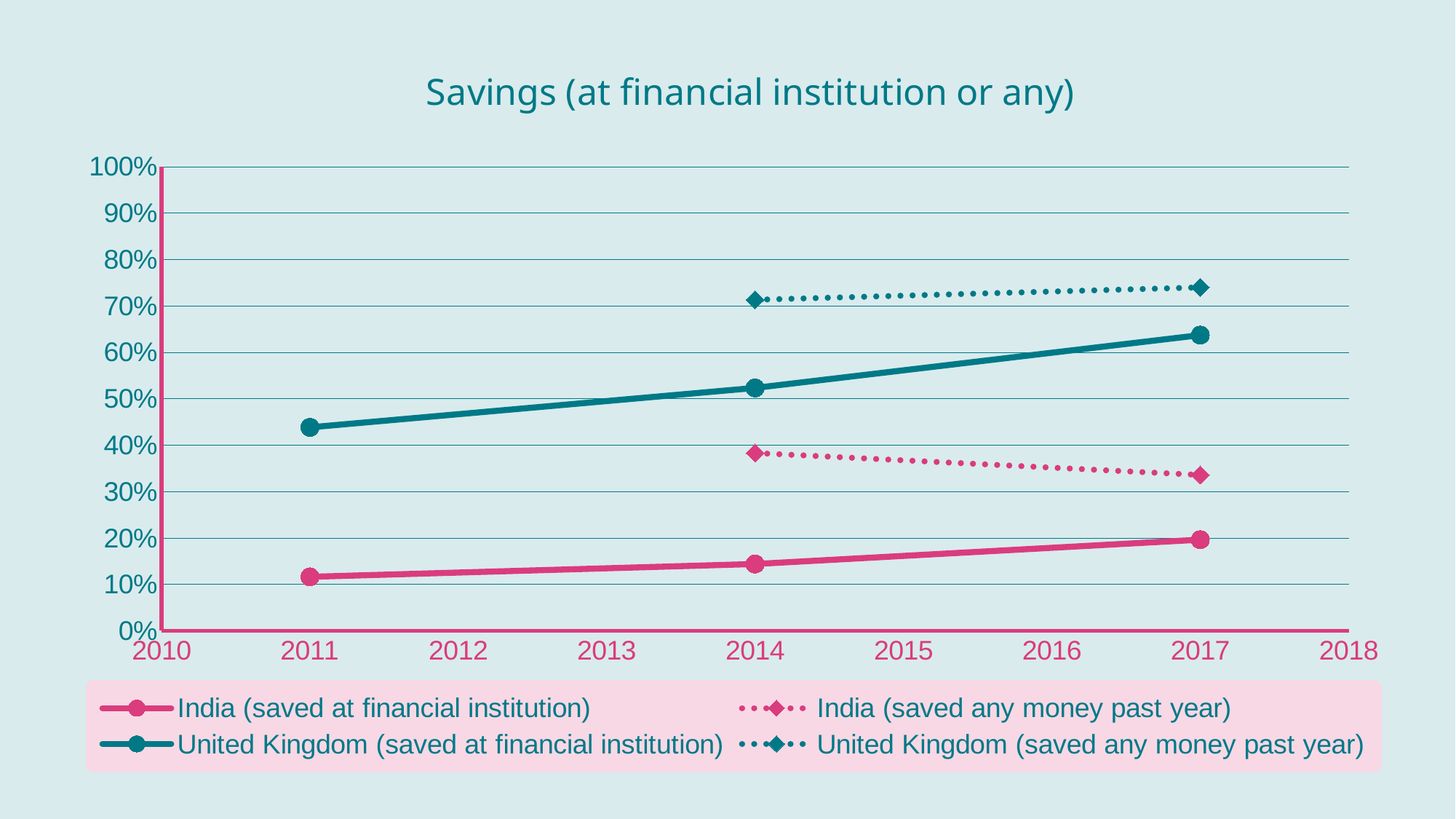
Which series has the highest value in 2017? United Kingdom (saved any money past year) Is the value for United Kingdom (saved any money past year) in 2014 greater or less than 60%? greater How many data points are plotted for the India (saved any money past year) series? 2 Does the India (saved any money past year) series rise or fall from 2014 to 2017? fall How many series does the legend list? 4 Does the United Kingdom (saved at financial institution) series rise or fall from 2011 to 2017? rise Is the value for United Kingdom (saved at financial institution) in 2017 greater or less than 60%? greater What kind of chart is shown on the slide? line chart Is the value for India (saved at financial institution) in 2011 greater or less than 20%? less What is the title of the chart? Savings (at financial institution or any) How many data points are plotted for the India (saved at financial institution) series? 3